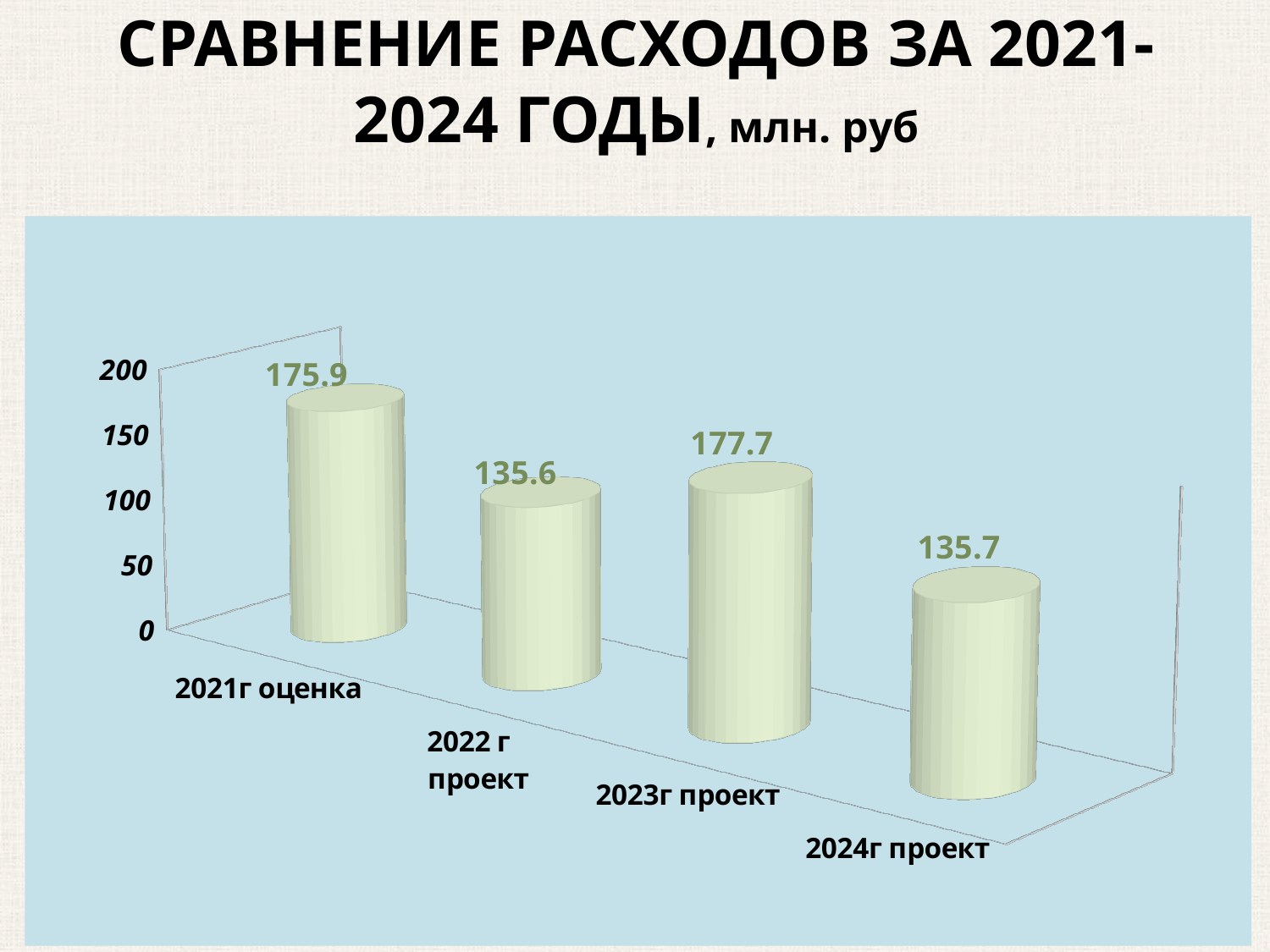
Which category has the highest value? 2023г проект How many categories are shown on the chart? 4 What is the difference between the values for 2021г оценка and 2022 г проект? 40.3 Which category has the lowest value? 2022 г проект What kind of chart is shown on the slide? bar chart What unit is given in the chart title? млн. руб What is the value for 2021г оценка? 175.9 What is the value for 2024г проект? 135.7 What is the value for 2022 г проект? 135.6 What is the value for 2023г проект? 177.7 What is the difference between the values for 2023г проект and 2024г проект? 42.0 Which is larger, the value for 2021г оценка or the value for 2023г проект? 2023г проект